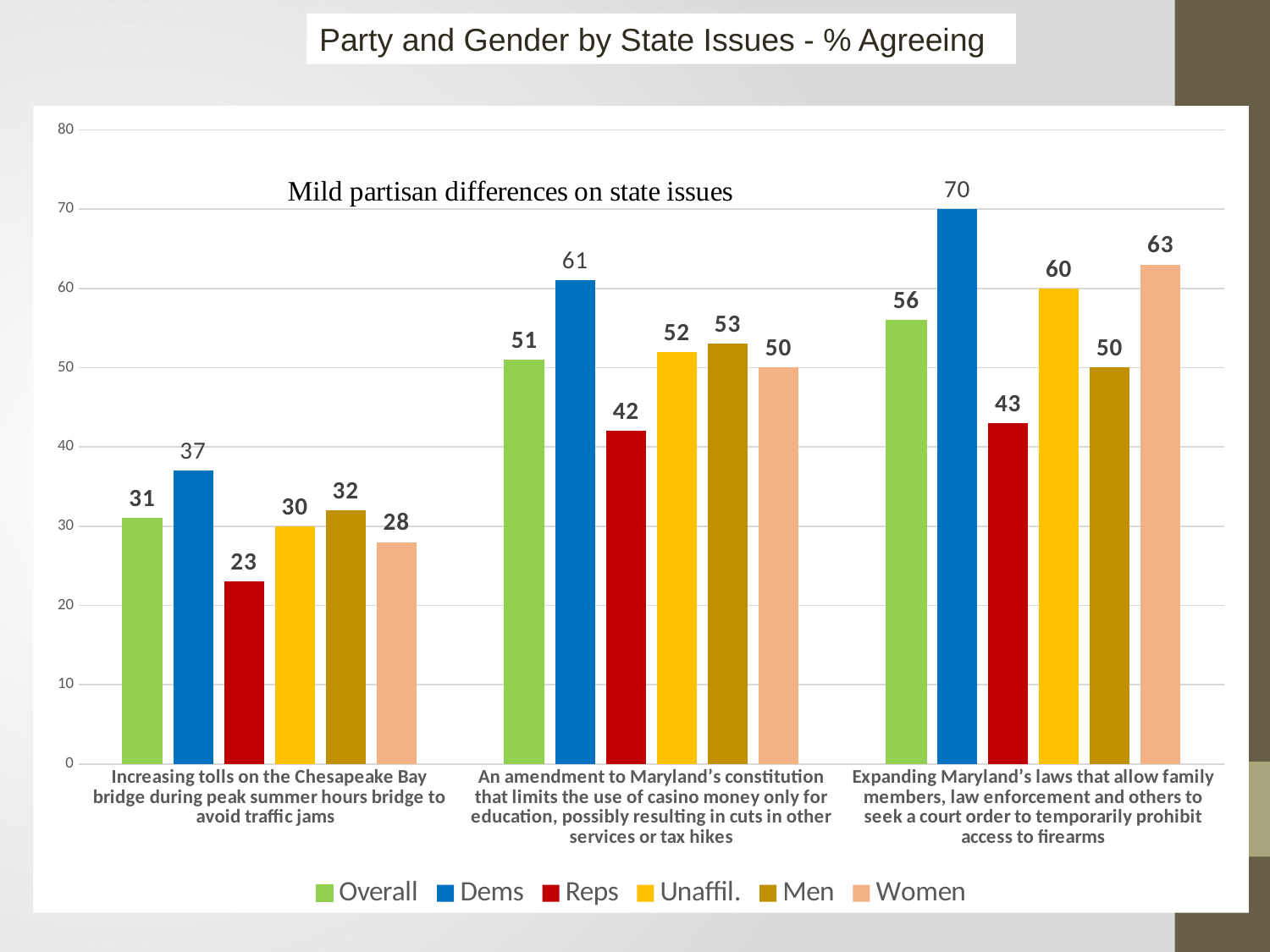
What is the value for Women on the casino money amendment issue? 50 What is the title of the slide? Party and Gender by State Issues - % Agreeing What is the value for Dems on the firearms court order issue? 70 What kind of chart is shown on the slide? Bar chart Which series has the highest value for the Chesapeake Bay bridge tolls issue? Dems Which is larger on the firearms court order issue, Men or Women? Women What is the value for Reps on increasing tolls on the Chesapeake Bay bridge? 23 How many series does the legend list? 6 What colour are the Reps bars? Red Which series has the lowest value for the firearms court order issue? Reps What is the difference between Dems and Reps on the casino money amendment issue? 19 How many issue categories are shown on the x axis? 3